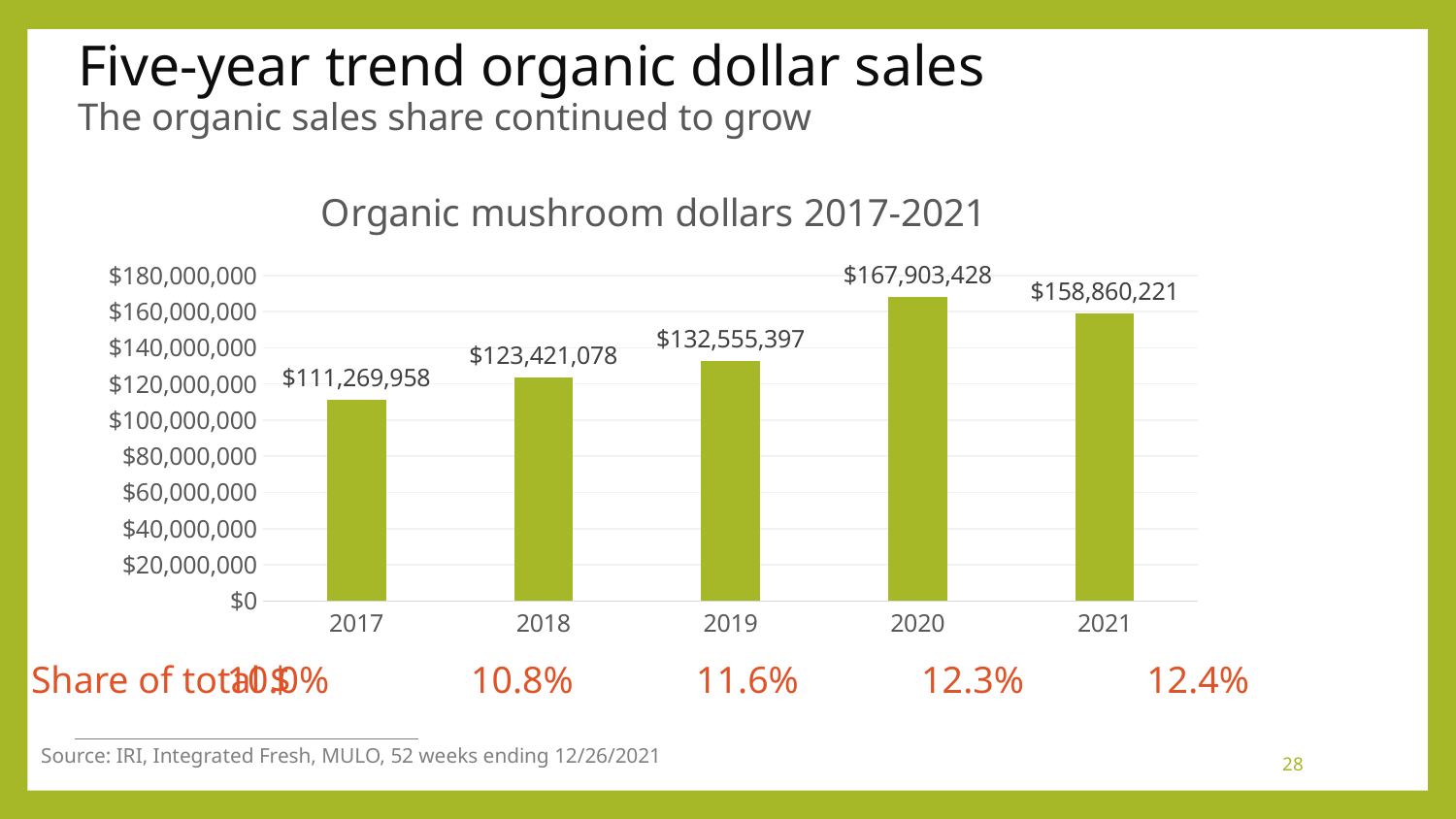
What is the difference between the 2020 and 2021 values in the chart? $9,043,207 What is the value for 2017 in the Organic mushroom dollars 2017-2021 chart? $111,269,958 How many years are shown on the x axis of the chart? 5 Is the value for 2019 greater or less than $140,000,000? less What kind of chart is shown on the slide? bar chart Which is larger, the value for 2019 or the value for 2021? 2021 What is the value for 2020 in the Organic mushroom dollars 2017-2021 chart? $167,903,428 Which year has the lowest organic mushroom dollar sales? 2017 Do the values rise or fall from 2017 to 2020? rise What is the difference between the 2018 and 2017 values in the chart? $12,151,120 Which year has the highest organic mushroom dollar sales? 2020 What is the value for 2021 in the Organic mushroom dollars 2017-2021 chart? $158,860,221